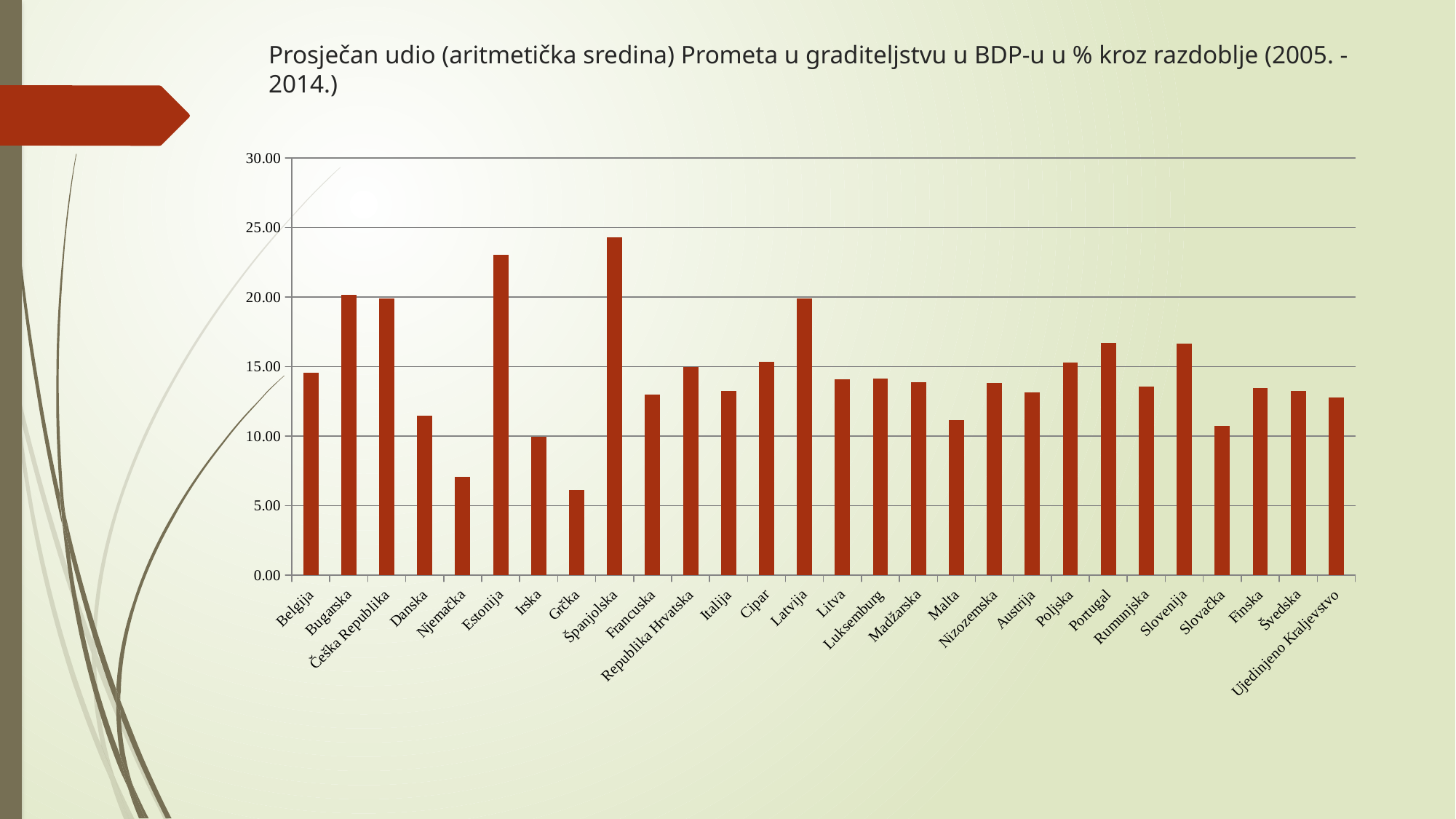
Is the value for Portugal greater or less than 15.00? greater Is the value for Estonija greater or less than 20.00? greater Which has the larger value, Latvija or Litva? Latvija Is the value for Danska greater or less than 10.00? greater What is the highest value shown on the y axis of the chart? 30.00 How many countries are shown on the x axis of the chart? 28 Which country has the lowest bar in the chart? Grčka Which country has the highest bar in the chart? Španjolska What kind of chart is shown on the slide? bar chart Which has the larger value, Bugarska or Danska? Bugarska